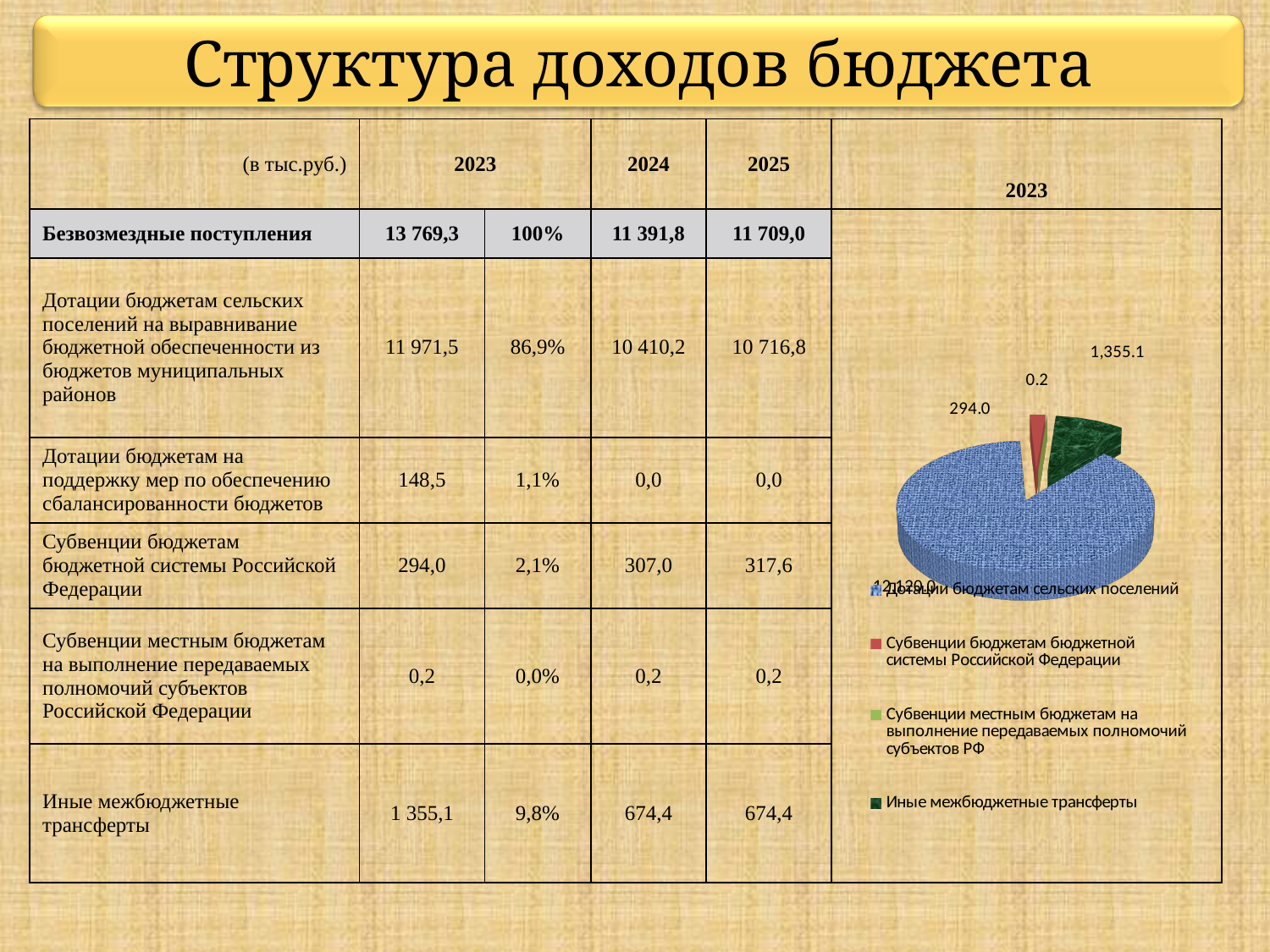
Which category has the smallest slice in the pie chart? Субвенции местным бюджетам на выполнение передаваемых полномочий субъектов РФ What value is labelled on the pie chart for Иные межбюджетные трансферты? 1,355.1 What is the title of the pie chart? 2023 What kind of chart is shown on the slide? pie chart What value is labelled on the pie chart for Субвенции местным бюджетам на выполнение передаваемых полномочий субъектов РФ? 0.2 How many slices does the pie chart have? 4 How many entries does the pie chart's legend list? 4 What colour is the largest slice of the pie chart? blue In the pie chart, which is larger: Иные межбюджетные трансферты or Субвенции бюджетам бюджетной системы Российской Федерации? Иные межбюджетные трансферты In the pie chart, what is the difference between the values for Иные межбюджетные трансферты and Субвенции бюджетам бюджетной системы Российской Федерации? 1,061.1 What value is labelled on the pie chart for Субвенции бюджетам бюджетной системы Российской Федерации? 294.0 Which category has the largest slice in the pie chart? Дотации бюджетам сельских поселений